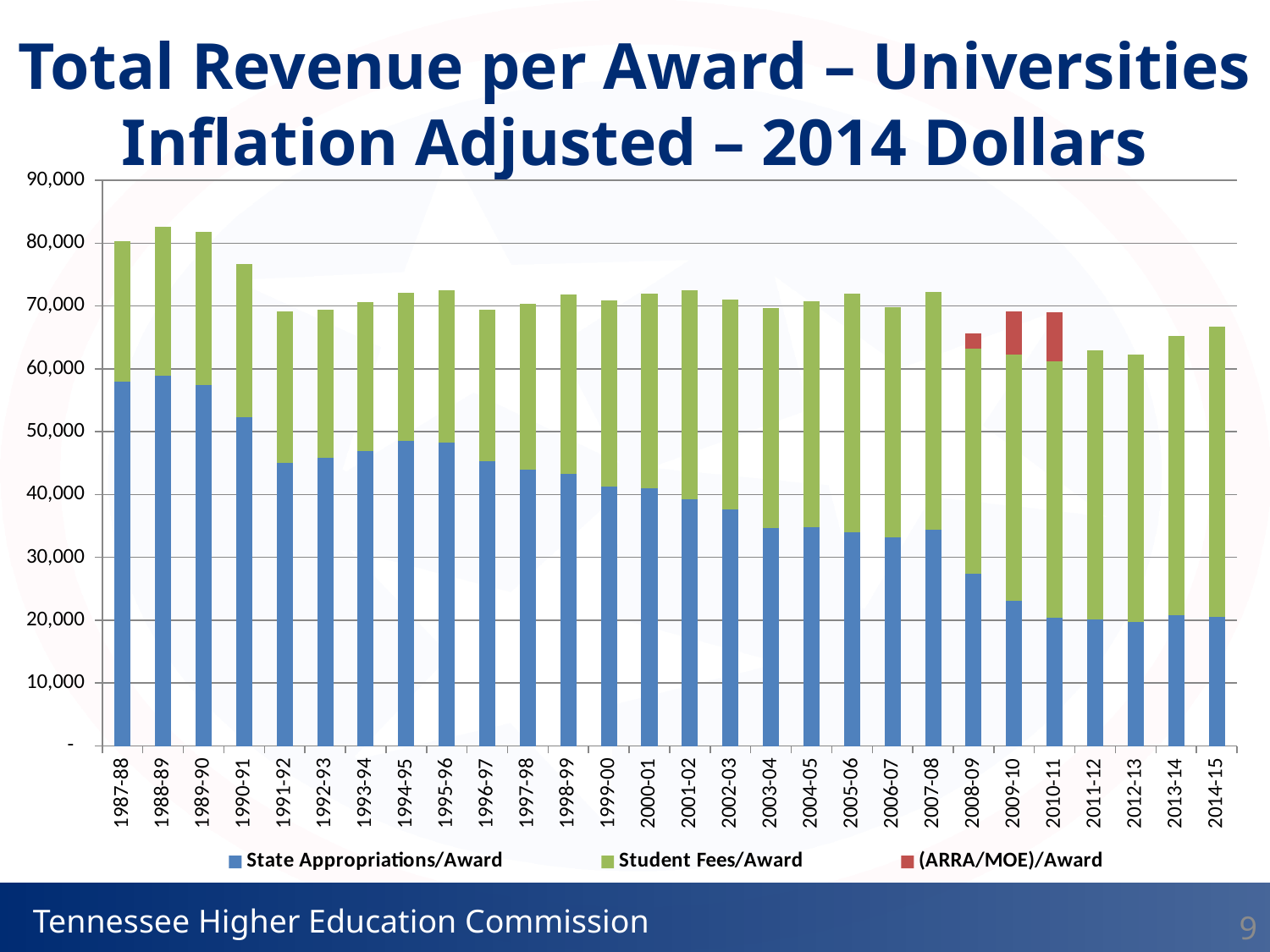
How many academic years are shown along the x axis? 28 Is the total revenue per award for 2011-12 greater or less than 70,000? less Is the State Appropriations/Award value for 2014-15 greater or less than 30,000? less Is the total revenue per award for 1988-89 greater or less than 80,000? greater In how many years does the (ARRA/MOE)/Award series appear in the chart? 3 What colour represents Student Fees/Award in the chart? Green Which is larger, the State Appropriations/Award value for 1987-88 or for 2014-15? 1987-88 Which year has the larger total revenue per award, 1990-91 or 1991-92? 1990-91 What kind of chart is shown on the slide? Stacked bar chart How many series does the legend list? 3 Does the State Appropriations/Award series generally rise or fall from 1987-88 to 2014-15? fall